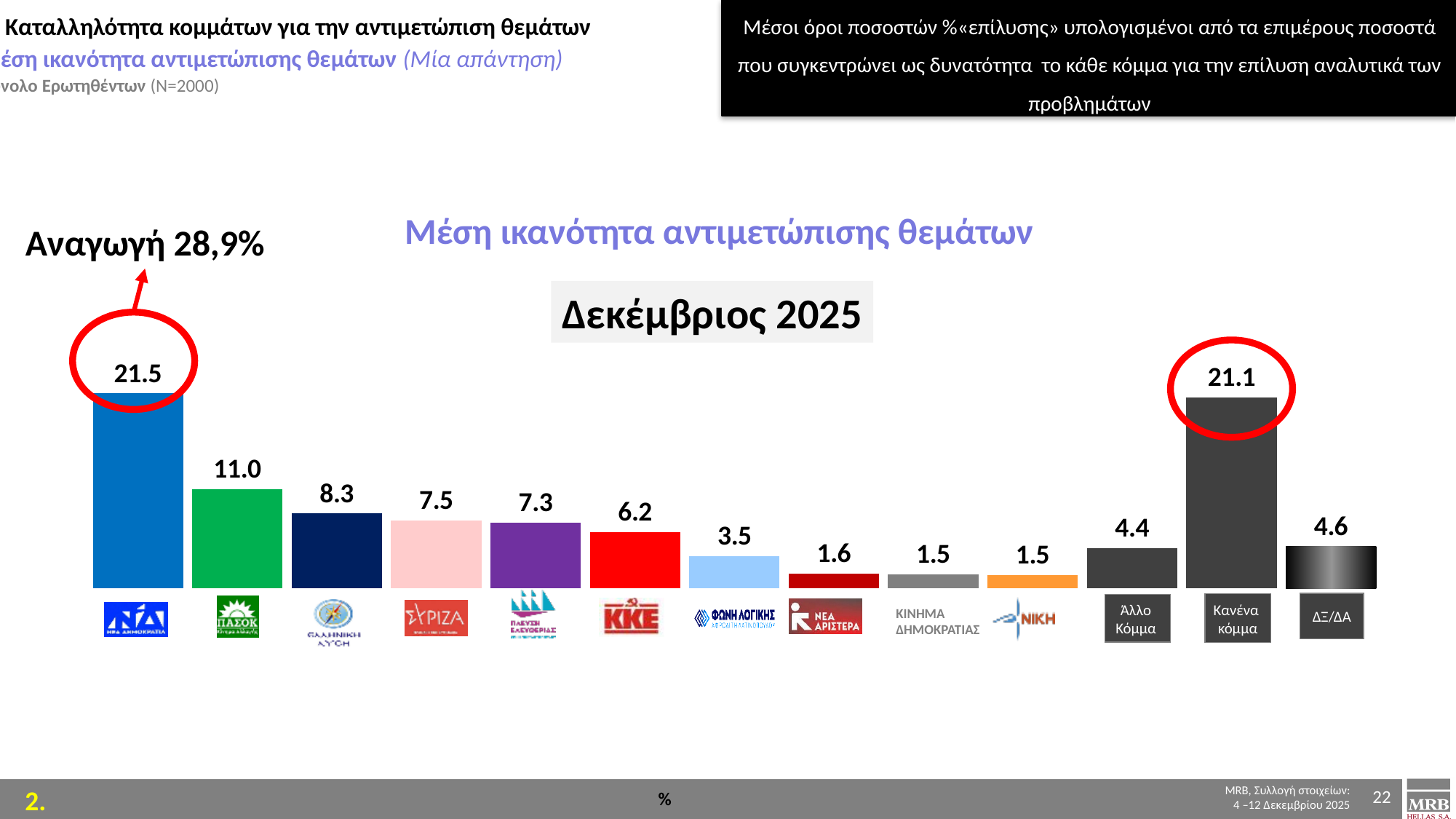
What is the value shown for ΣΥΡΙΖΑ? 7.5 How many bars are shown in the chart? 13 Which is larger, the value for ΚΚΕ or the value for Άλλο Κόμμα? ΚΚΕ What is the value shown for ΔΞ/ΔΑ? 4.6 Which category has the highest value in the chart? ΝΔ (Νέα Δημοκρατία) What is the value shown for Κανένα κόμμα? 21.1 What kind of chart is shown on the slide? Bar chart What is the 'Αναγωγή' percentage annotated above the ΝΔ bar? 28,9% What is the value shown for ΚΚΕ? 6.2 What is the difference between the values for ΝΔ and Κανένα κόμμα? 0.4 What is the value shown for ΠΑΣΟΚ? 11.0 What is the difference between the values for ΠΑΣΟΚ and ΣΥΡΙΖΑ? 3.5